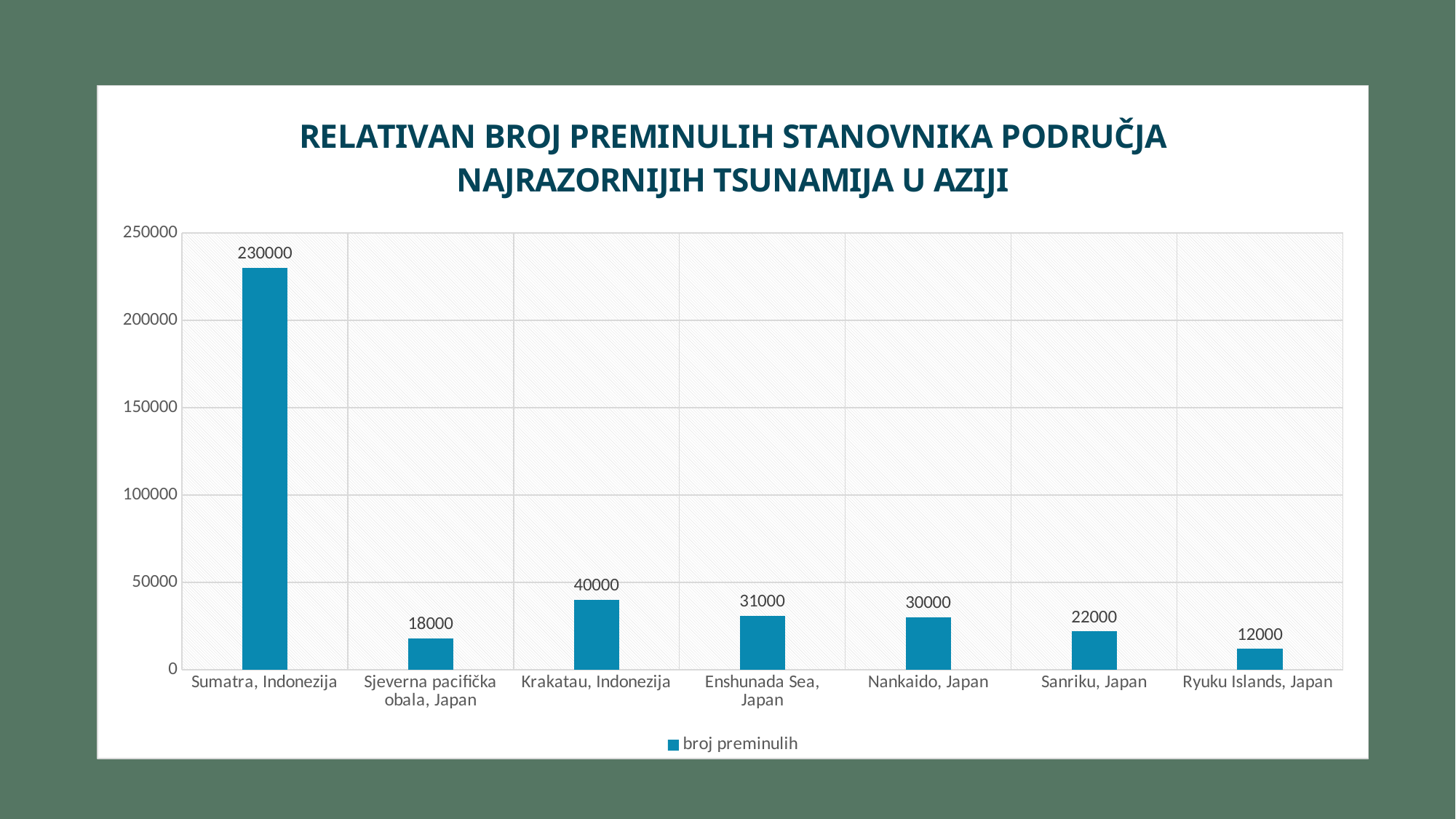
What is the value for Krakatau, Indonezija? 40000 Which category has the lowest value? Ryuku Islands, Japan Which category has the highest value? Sumatra, Indonezija How many categories are shown on the x axis? 7 Is the value for Sumatra, Indonezija greater or less than 200000? greater What is the name of the series listed in the legend? broj preminulih What is the value for Ryuku Islands, Japan? 12000 What is the value for Sjeverna pacifička obala, Japan? 18000 What is the difference between the values for Enshunada Sea, Japan and Nankaido, Japan? 1000 What kind of chart is shown on the slide? bar chart Which is larger, the value for Sanriku, Japan or the value for Krakatau, Indonezija? Krakatau, Indonezija What is the value for Sumatra, Indonezija? 230000